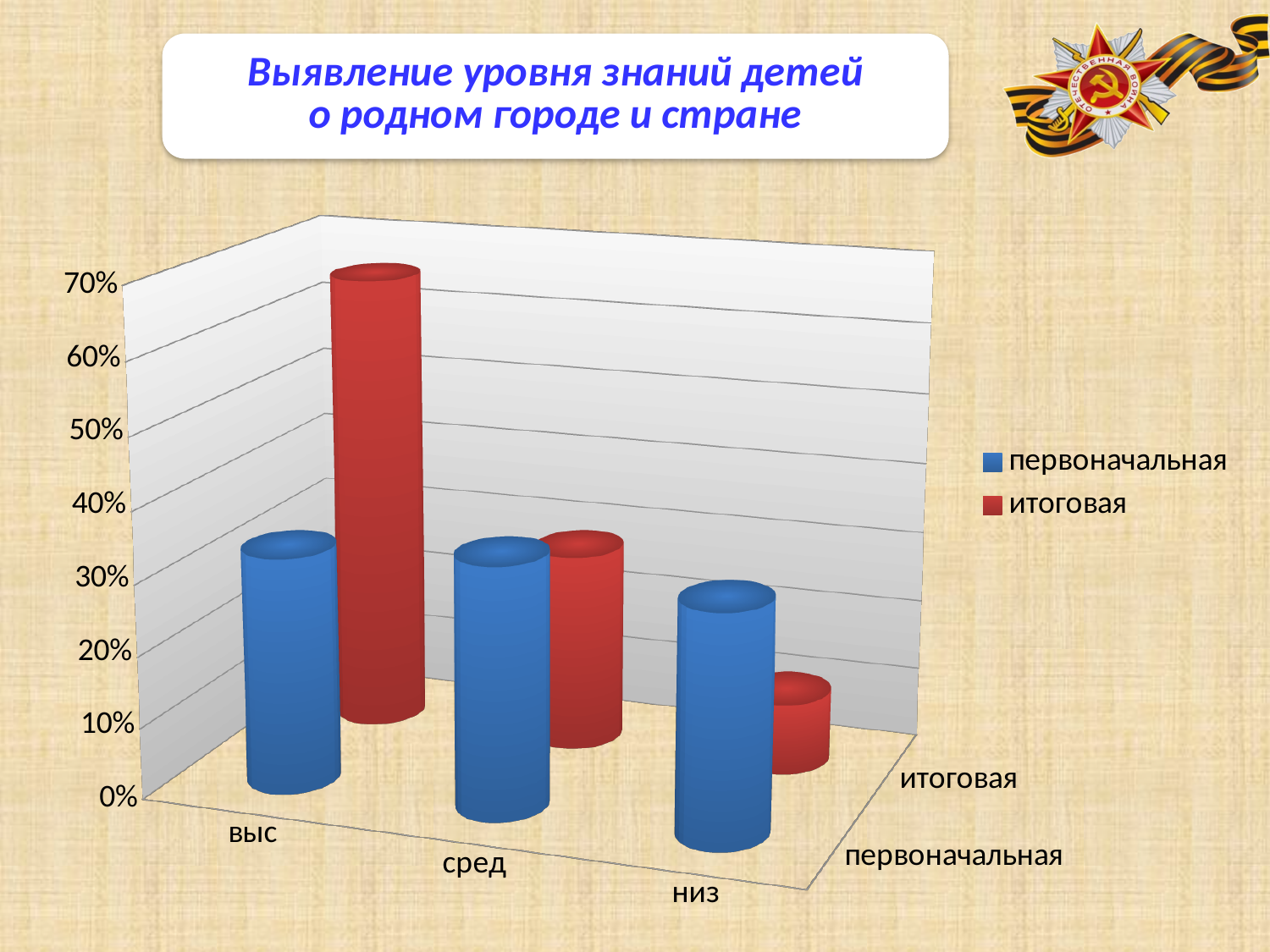
Which category has the highest value for the итоговая series? выс What kind of chart is shown on the slide? bar chart Is the итоговая value for выс greater or less than 50%? greater Is the итоговая value for низ greater or less than 20%? less For the category выс, which series has the larger value, первоначальная or итоговая? итоговая How many categories are shown on the x axis? 3 Do the итоговая values rise or fall going from выс to низ along the x axis? fall Which colour represents the первоначальная series in the legend? blue How many series does the legend list? 2 For the category низ, which series has the larger value, первоначальная or итоговая? первоначальная Which category has the lowest value for the итоговая series? низ Is the первоначальная value for выс greater or less than 20%? greater